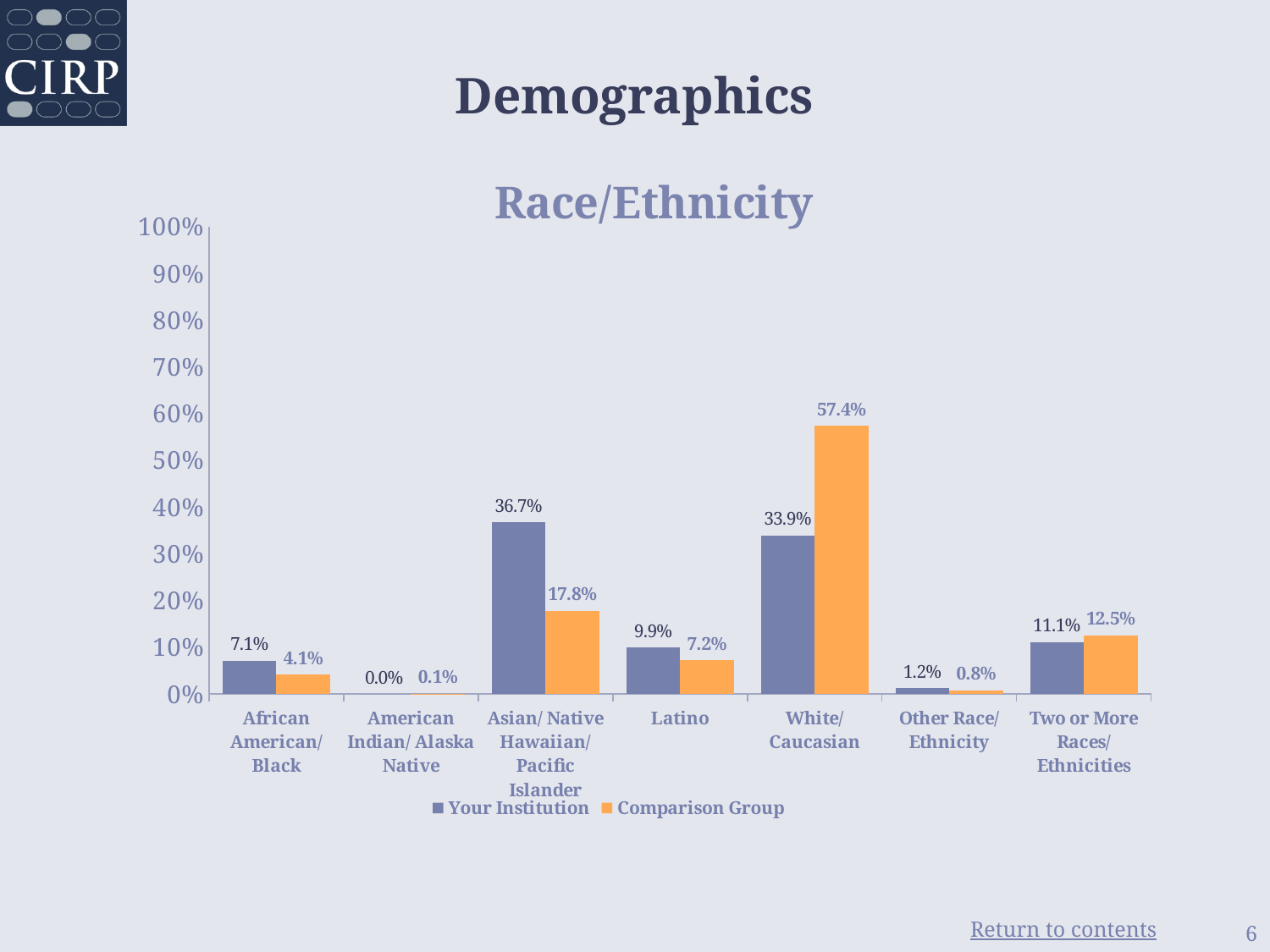
What is the value for the Comparison Group in the Asian/Native Hawaiian/Pacific Islander category? 17.8% How many race/ethnicity categories are shown on the x axis? 7 What is the value for Your Institution in the Latino category? 9.9% What kind of chart is shown on the slide? Bar chart How many series does the legend list? 2 Is the value for Your Institution in the Asian/Native Hawaiian/Pacific Islander category greater or less than 30%? greater Which category has the lowest value for Your Institution? American Indian/Alaska Native What is the difference between the Comparison Group and Your Institution values for White/Caucasian? 23.5% Which is larger for Two or More Races/Ethnicities: Your Institution or the Comparison Group? Comparison Group Which category has the highest value for the Comparison Group? White/Caucasian What is the value for Your Institution in the White/Caucasian category? 33.9% What is the title of the chart? Race/Ethnicity